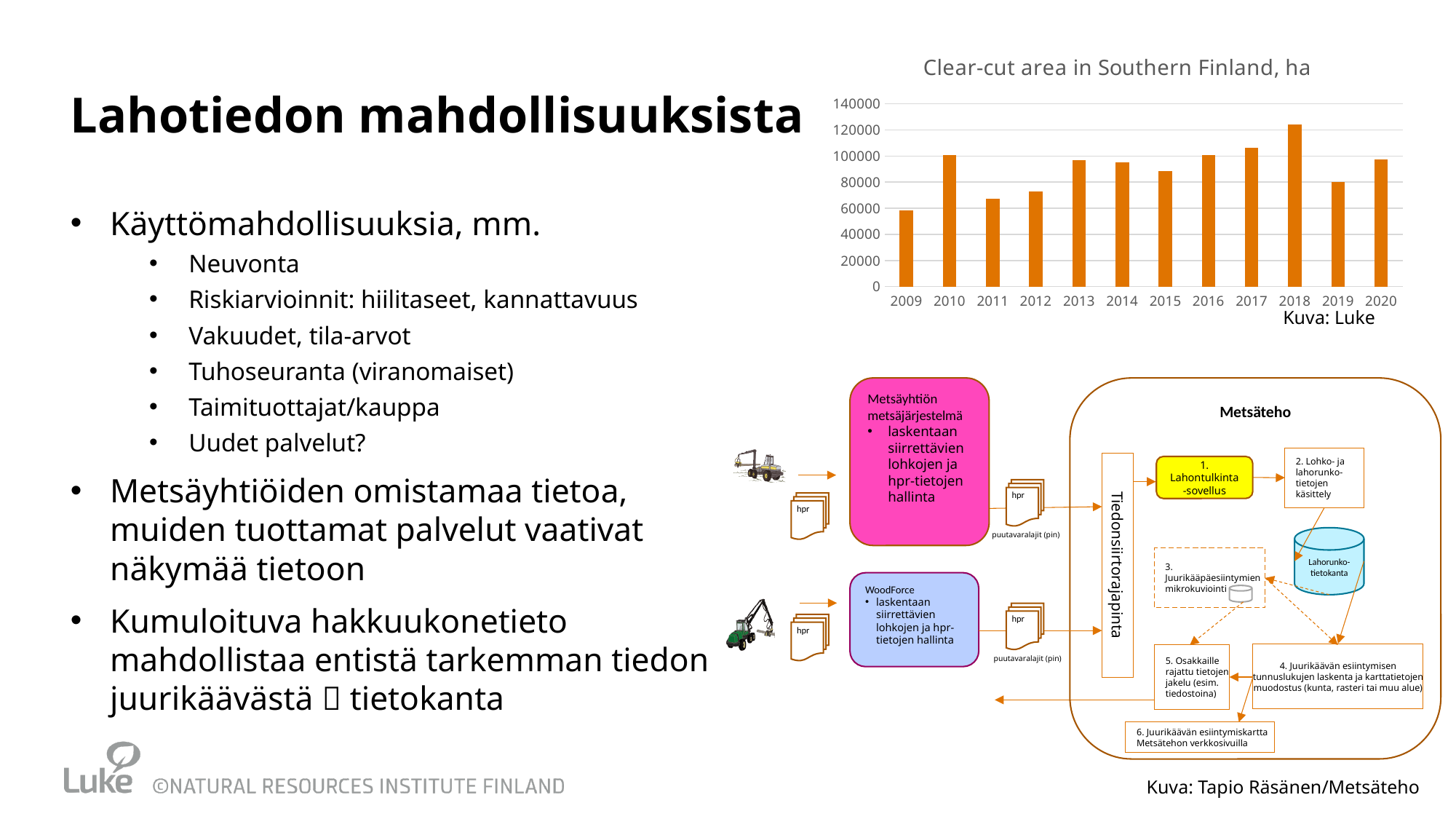
In the "Clear-cut area in Southern Finland, ha" chart, is the value for 2011 greater or less than 60000? greater In the "Clear-cut area in Southern Finland, ha" chart, is the value for 2018 greater or less than 120000? greater Which year has the highest clear-cut area in the "Clear-cut area in Southern Finland, ha" chart? 2018 What is the title of the bar chart on the slide? Clear-cut area in Southern Finland, ha In the "Clear-cut area in Southern Finland, ha" chart, which year has the larger clear-cut area, 2009 or 2010? 2010 How many years are shown on the x axis of the "Clear-cut area in Southern Finland, ha" chart? 12 Which year has the lowest clear-cut area in the "Clear-cut area in Southern Finland, ha" chart? 2009 What kind of chart is the "Clear-cut area in Southern Finland, ha" chart? bar chart In the "Clear-cut area in Southern Finland, ha" chart, does the clear-cut area rise or fall from 2018 to 2019? fall In the "Clear-cut area in Southern Finland, ha" chart, which year has the larger clear-cut area, 2018 or 2019? 2018 In the "Clear-cut area in Southern Finland, ha" chart, is the value for 2019 greater or less than 100000? less